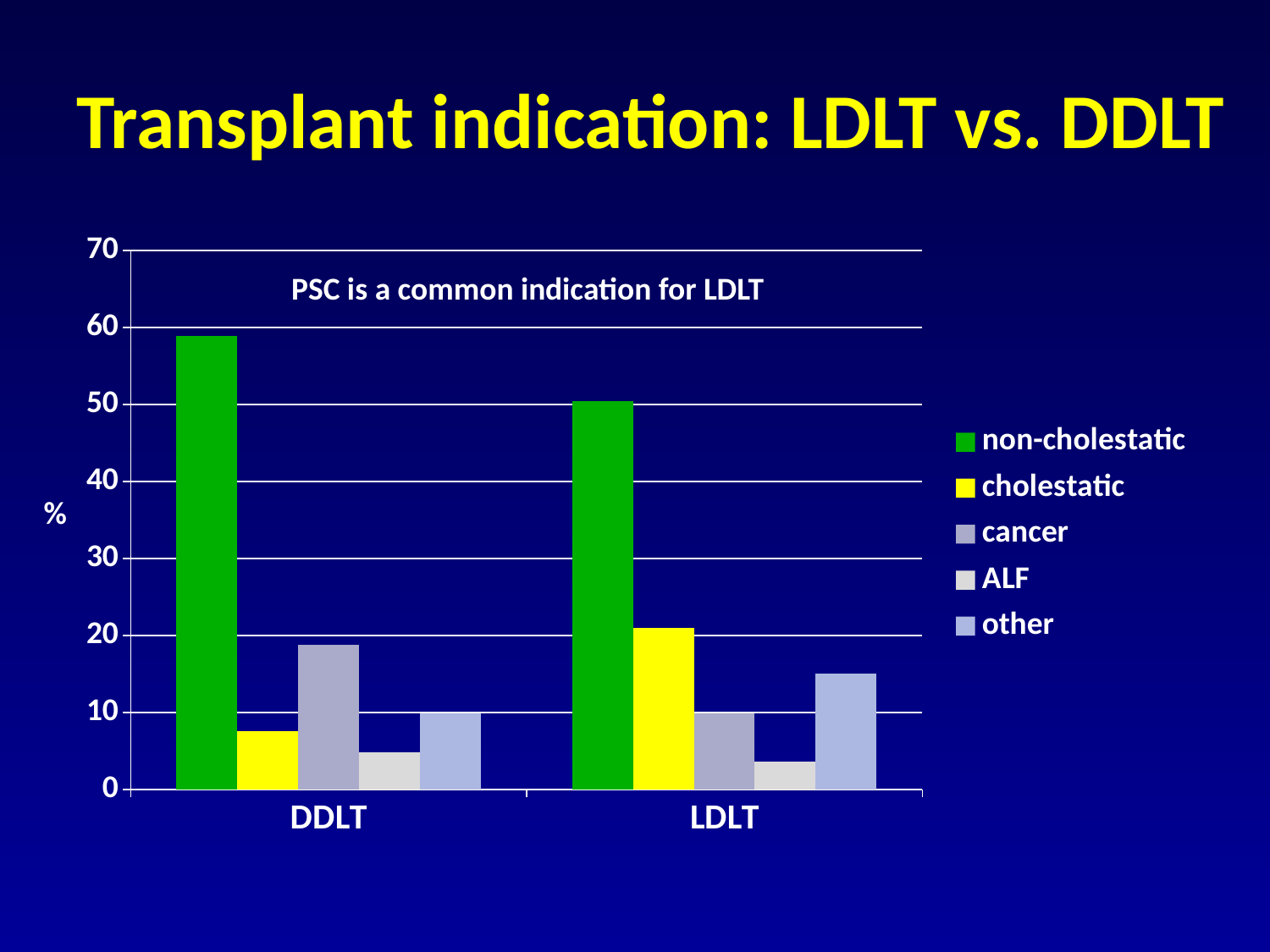
Which indication has the lowest value for DDLT? ALF What kind of chart is shown on the slide? bar chart Is the cancer value for DDLT or for LDLT larger? DDLT Which indication has the lowest value for LDLT? ALF Is the non-cholestatic value for DDLT greater or less than 50? greater What text annotation is shown inside the chart area? PSC is a common indication for LDLT How many series does the legend list? 5 Is the ALF value for DDLT greater or less than 10? less Is the cholestatic value for DDLT or for LDLT larger? LDLT Which indication has the highest value for DDLT? non-cholestatic How many categories are shown on the x axis? 2 Is the non-cholestatic value for DDLT or for LDLT larger? DDLT